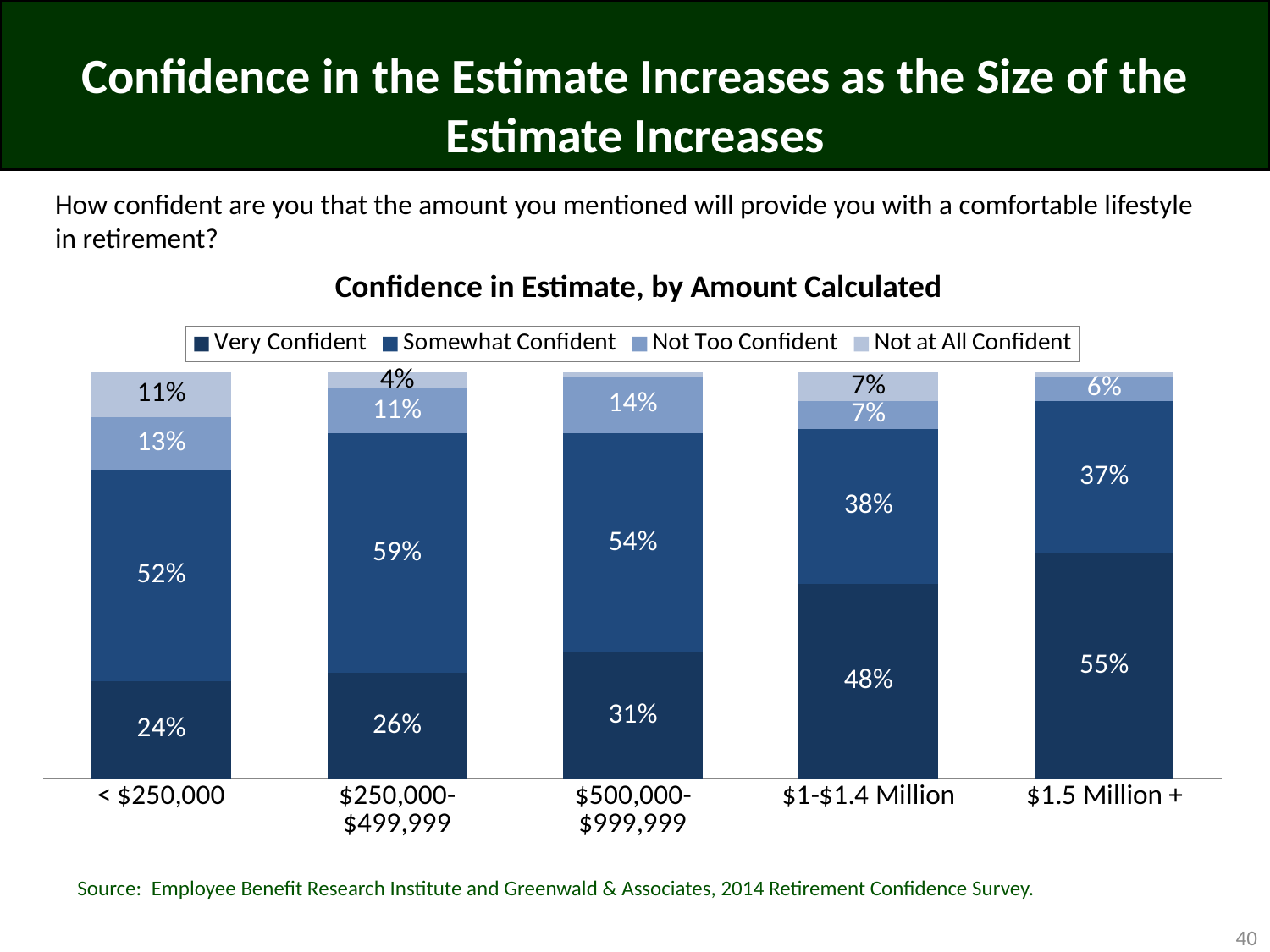
How many series does the legend list? 4 What is the Very Confident value for the $1.5 Million + category? 55% Which category has the lowest Very Confident value? < $250,000 What is the difference between the Very Confident values for $1.5 Million + and < $250,000? 31 percentage points What is the Not at All Confident value for the $250,000-$499,999 category? 4% Which has the larger Somewhat Confident value: < $250,000 or $500,000-$999,999? $500,000-$999,999 How many amount categories are shown on the x axis? 5 What is the total of the stacked bar for the < $250,000 category? 100% Does the Very Confident value rise or fall as the amount calculated increases along the x axis? Rises What is the Somewhat Confident value for the $250,000-$499,999 category? 59% Which category has the highest Very Confident value? $1.5 Million + What kind of chart is shown on the slide? Stacked bar chart